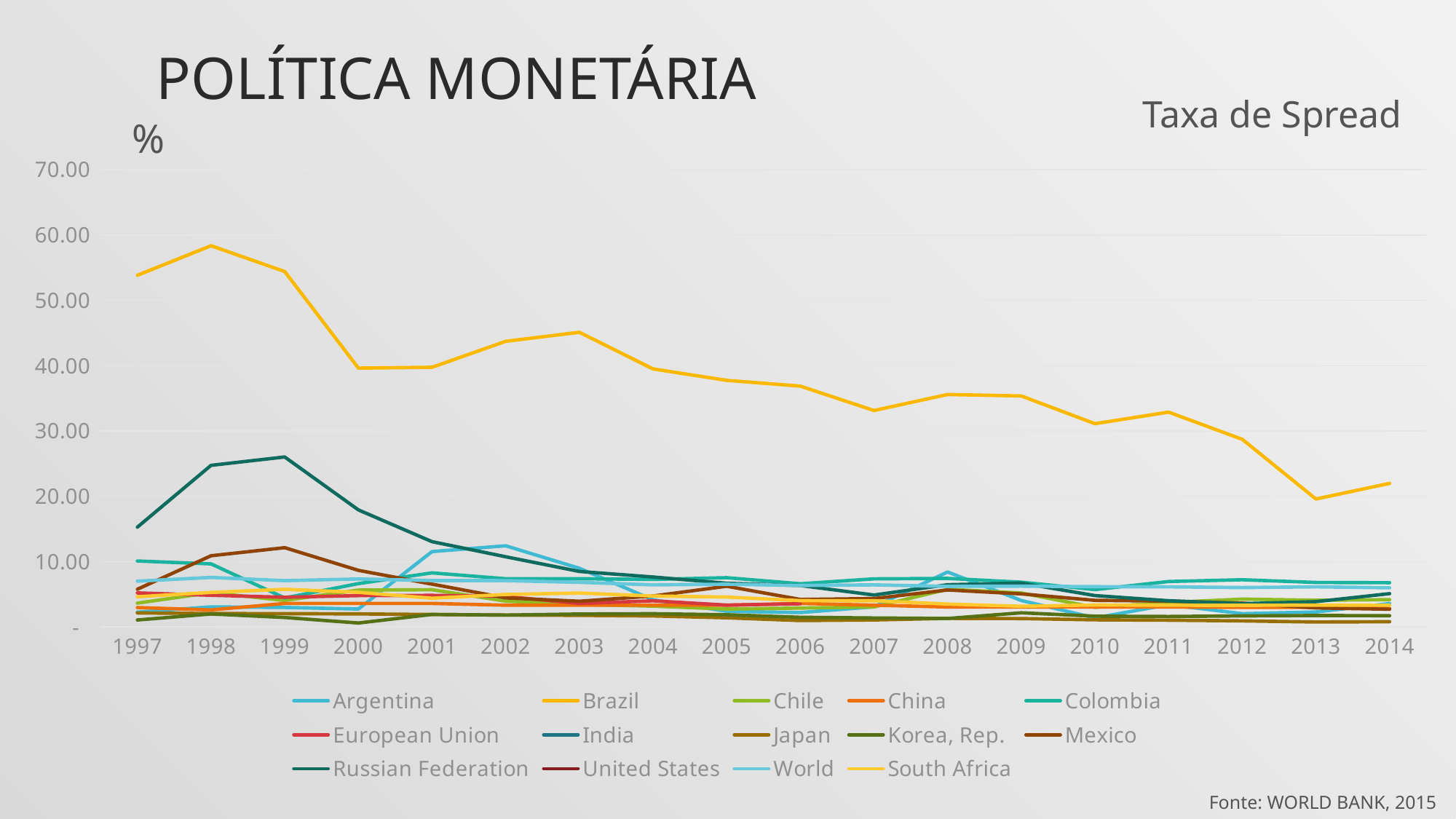
How many series does the legend list? 14 How many years are shown along the x axis? 18 Does the value for Brazil generally rise or fall from 1997 to 2014? fall What is the title of the chart? Taxa de Spread Which is larger in 1998, the value for Brazil or the value for the Russian Federation? Brazil Which series has the highest value across the whole period? Brazil Which country has the highest spread rate in 1999? Brazil Is the value for Brazil in 2012 greater or less than 30? less Is the value for Brazil in 1998 greater or less than 50? greater Is the value for Brazil in 2003 greater or less than 40? greater What kind of chart is shown on the slide? line chart